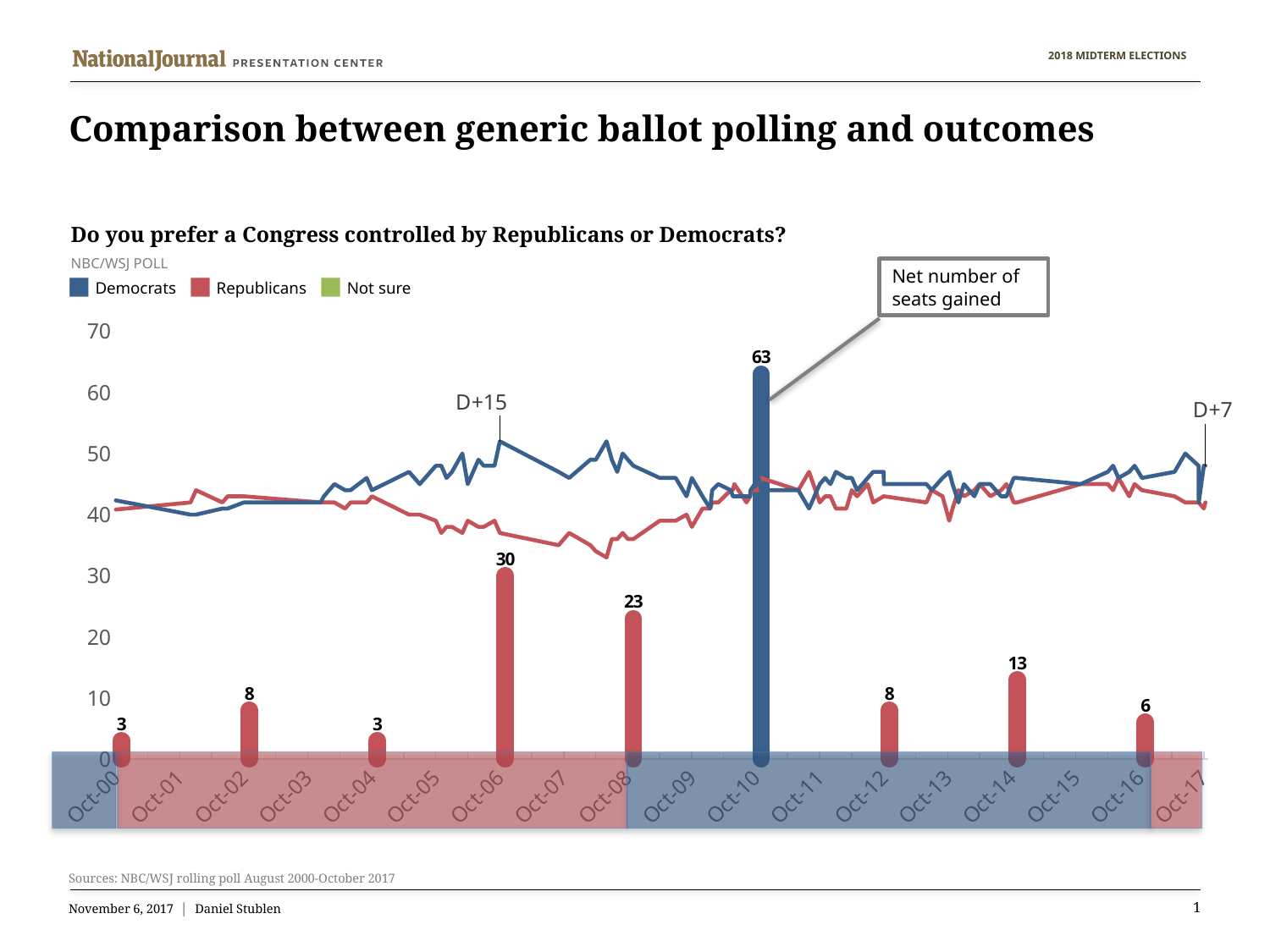
How many net-seats-gained bars are plotted on the chart? 9 What is the net number of seats gained shown for Oct-10? 63 What is the difference between the net seats gained in Oct-06 and Oct-08? 7 What is the net number of seats gained shown for Oct-14? 13 What is the net number of seats gained shown for Oct-06? 30 Which is larger, the net seats gained in Oct-12 or in Oct-16? Oct-12 How many series does the legend list? 3 Which election year bar shows the highest net number of seats gained? Oct-10 What annotation is shown near the end of the chart at Oct-17? D+7 Is the Republicans line value at Oct-08 greater or less than 40? less What is the chart's title? Do you prefer a Congress controlled by Republicans or Democrats? Is the Democrats line value at Oct-06 greater or less than 40? greater